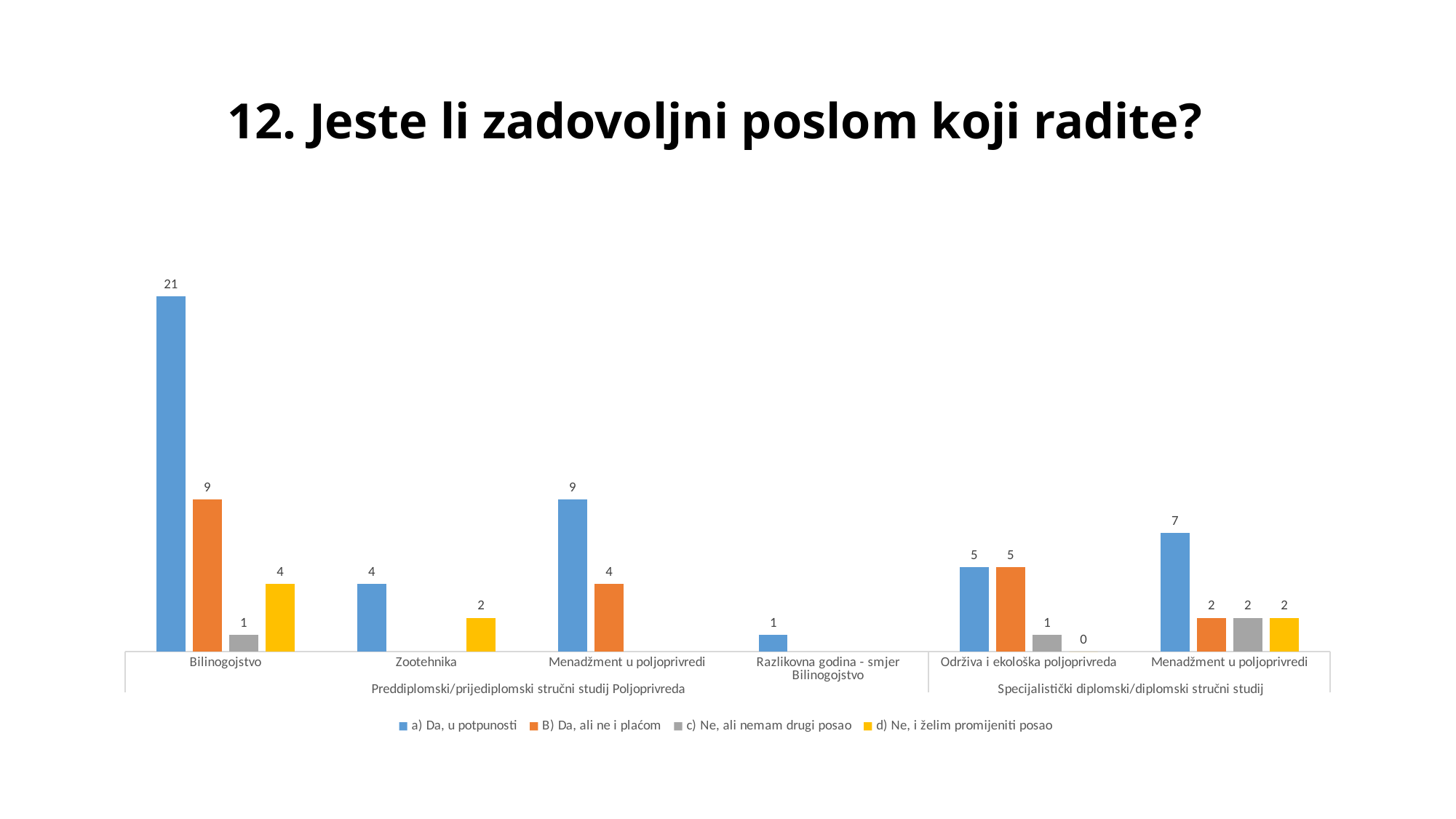
What is the value for 'a) Da, u potpunosti' for Menadžment u poljoprivredi in the Specijalistički diplomski/diplomski stručni studij group? 7 Which is larger for Menadžment u poljoprivredi in the Preddiplomski/prijediplomski stručni studij Poljoprivreda group: 'a) Da, u potpunosti' or 'B) Da, ali ne i plaćom'? a) Da, u potpunosti What is the difference between the 'a) Da, u potpunosti' and 'B) Da, ali ne i plaćom' values for Bilinogojstvo? 12 What is the value for 'd) Ne, i želim promijeniti posao' for Zootehnika? 2 What is the title of the chart? 12. Jeste li zadovoljni poslom koji radite? What is the value for 'c) Ne, ali nemam drugi posao' for Održiva i ekološka poljoprivreda? 1 What kind of chart is shown on the slide? bar chart Which category has the highest value for 'a) Da, u potpunosti'? Bilinogojstvo Which category has the lowest value for 'a) Da, u potpunosti'? Razlikovna godina - smjer Bilinogojstvo How many series does the legend list? 4 What is the value for 'a) Da, u potpunosti' for Bilinogojstvo? 21 What is the value for 'B) Da, ali ne i plaćom' for Bilinogojstvo? 9